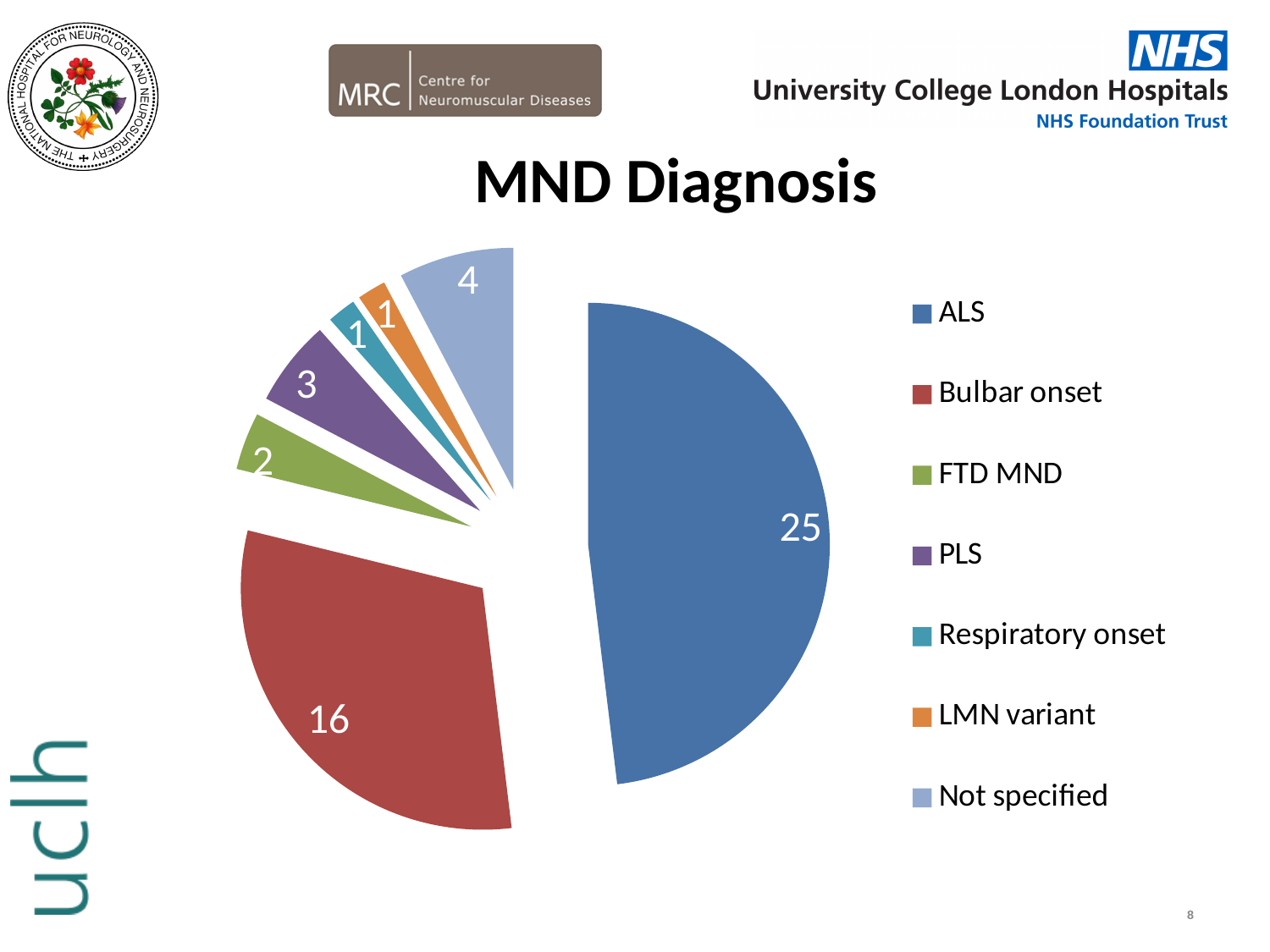
What is the value for Not specified? 4 What is the value for ALS? 25 What is the difference between the ALS and Bulbar onset values? 9 What is the title of the chart? MND Diagnosis Which is larger, the value for PLS or the value for FTD MND? PLS What is the value for PLS? 3 What type of chart is shown on the slide? Pie chart Rounded to the nearest whole percent, what share of the total does ALS represent? 48% How many categories does the legend list? 7 What is the value for Bulbar onset? 16 Which category has the largest slice? ALS What is the total of all the slices in the pie? 52